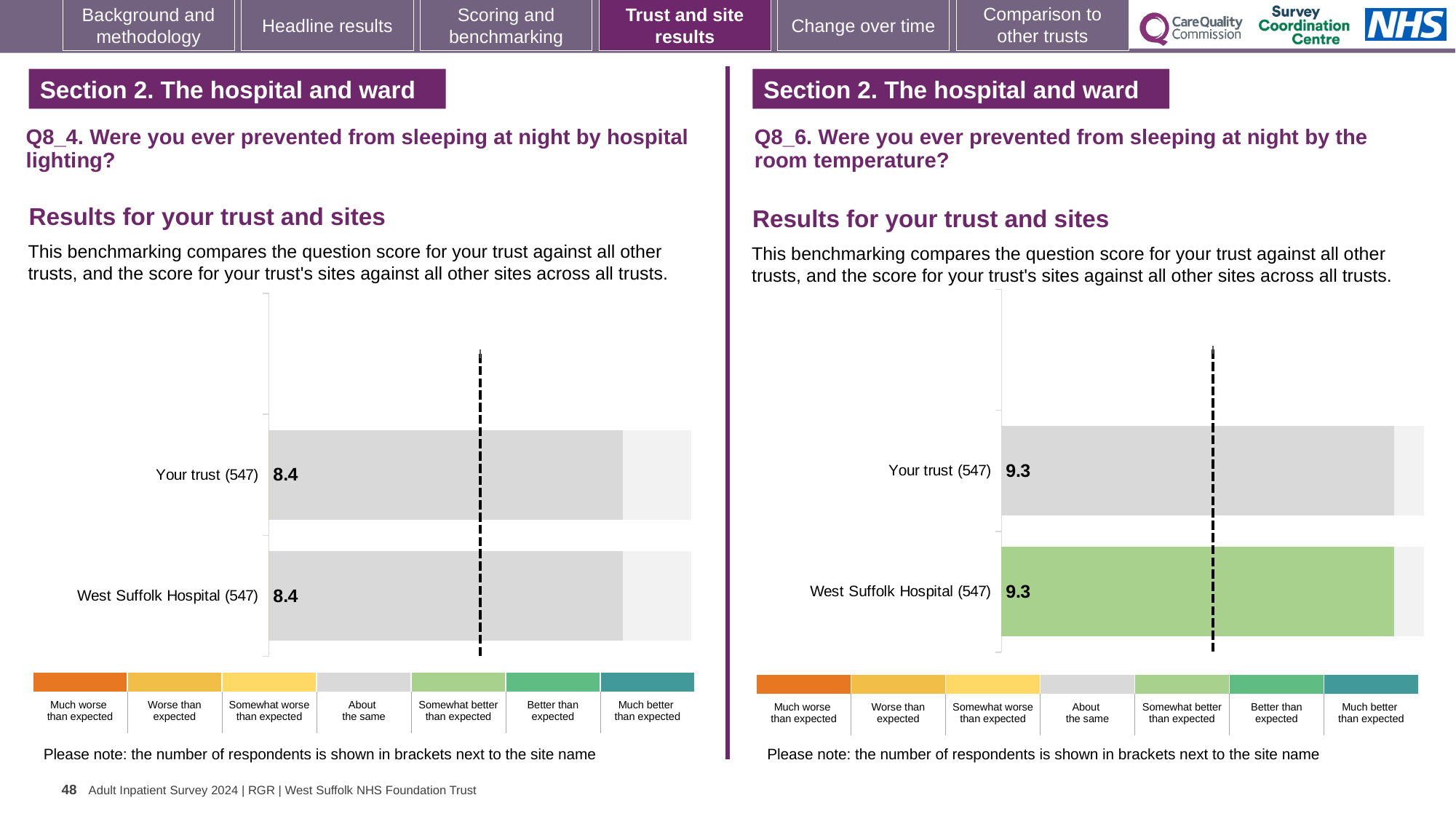
On the Q8_6 room temperature chart, what is the score for Your trust (547)? 9.3 On the Q8_6 room temperature chart, what is the score for West Suffolk Hospital (547)? 9.3 On the Q8_4 hospital lighting chart, which benchmark category does the colour of the Your trust (547) bar indicate? About the same On the Q8_4 hospital lighting chart, what is the score for West Suffolk Hospital (547)? 8.4 On the Q8_6 room temperature chart, what is the difference between the Your trust score and the West Suffolk Hospital score? 0.0 How many bars are plotted on the Q8_4 hospital lighting chart? 2 On the Q8_6 room temperature chart, which benchmark category does the colour of the West Suffolk Hospital (547) bar indicate? Somewhat better than expected How many respondents are shown in brackets for West Suffolk Hospital on the Q8_4 hospital lighting chart? 547 What kind of chart is used on the Q8_6 room temperature chart? Bar chart How many bars are plotted on the Q8_6 room temperature chart? 2 On the Q8_4 hospital lighting chart, what is the score for Your trust (547)? 8.4 On the Q8_4 hospital lighting chart, what is the difference between the Your trust score and the West Suffolk Hospital score? 0.0